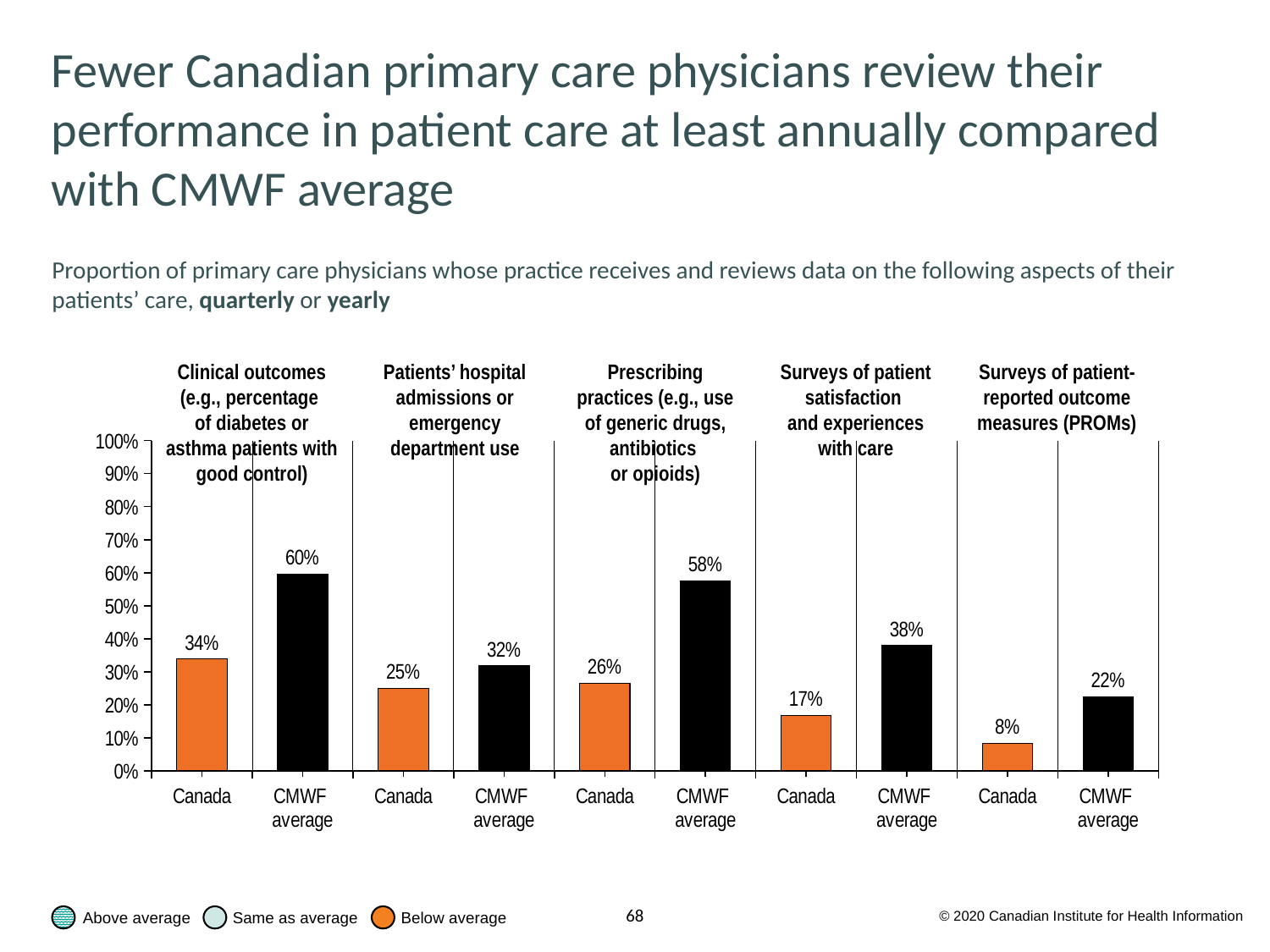
What is the difference between the CMWF average and Canada for Clinical outcomes? 26 percentage points What is the CMWF average for Surveys of patient satisfaction and experiences with care? 38% What kind of chart is shown on the slide? Bar chart Which bar has the lowest value on the chart? Canada for Surveys of patient-reported outcome measures (PROMs) (8%) Is the value for Canada under Surveys of patient satisfaction and experiences with care greater or less than 20%? less What is the value for Canada under Clinical outcomes? 34% What is the value for Canada under Surveys of patient-reported outcome measures (PROMs)? 8% How many aspects of patient care are shown on the chart? 5 Which bar has the highest value on the chart? CMWF average for Clinical outcomes (60%) What is the difference between the CMWF average and Canada for Patients' hospital admissions or emergency department use? 7 percentage points What is the CMWF average for Prescribing practices? 58% Which is larger for Prescribing practices: Canada or the CMWF average? CMWF average